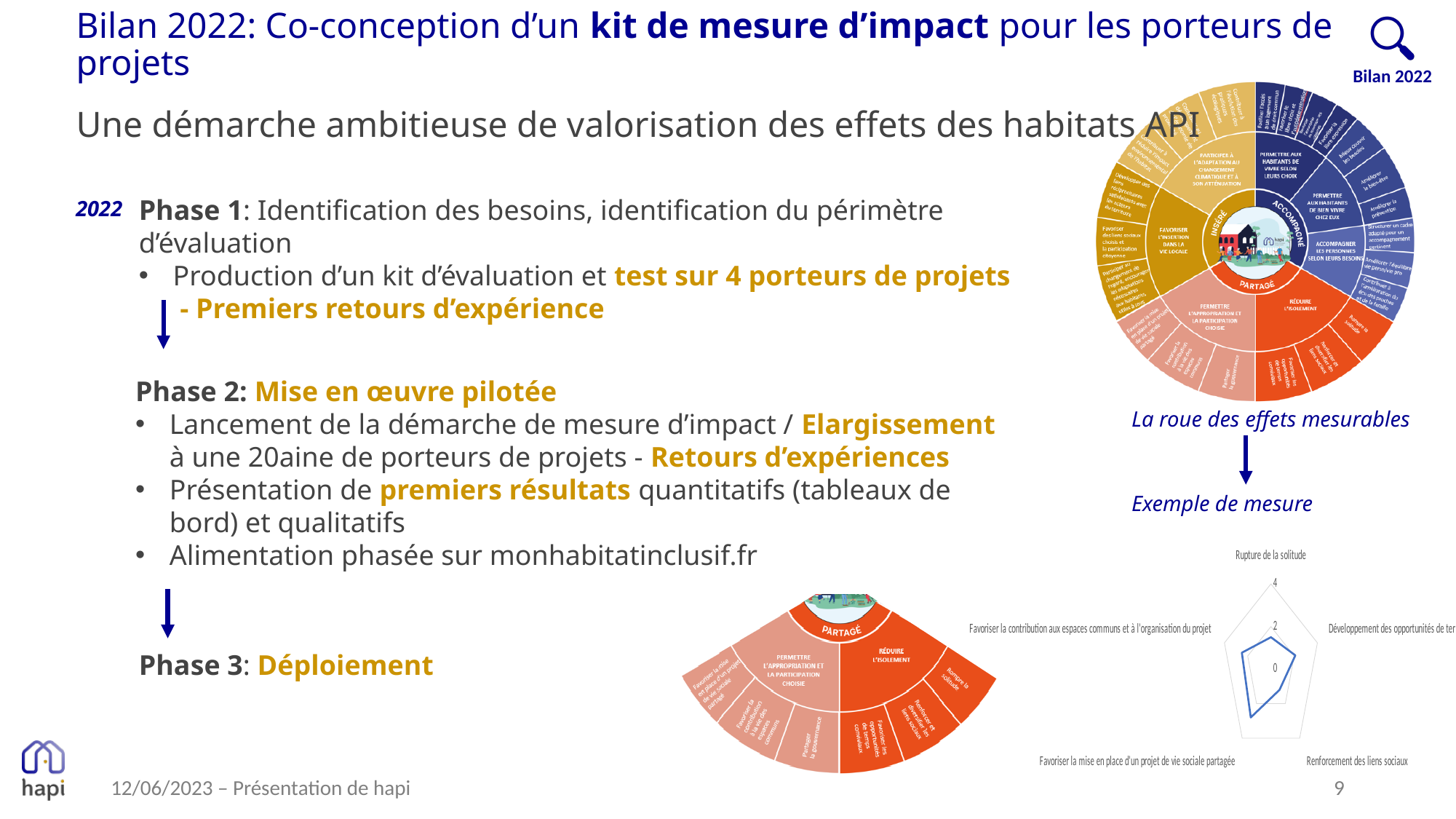
How many axes (categories) does the radar chart at the bottom right of the slide have? 5 On the radar chart at the bottom right, is the value for 'Renforcement des liens sociaux' greater or less than 4? less What kind of chart is the 'Exemple de mesure' chart at the bottom right of the slide? radar chart On the radar chart at the bottom right, what is the highest tick value shown on the axis scale? 4 On the radar chart at the bottom right, which category label appears at the top of the chart? Rupture de la solitude On the radar chart at the bottom right, is the value for 'Rupture de la solitude' greater or less than 4? less On the radar chart at the bottom right, is the value for 'Favoriser la contribution aux espaces communs et à l'organisation du projet' greater or less than 4? less